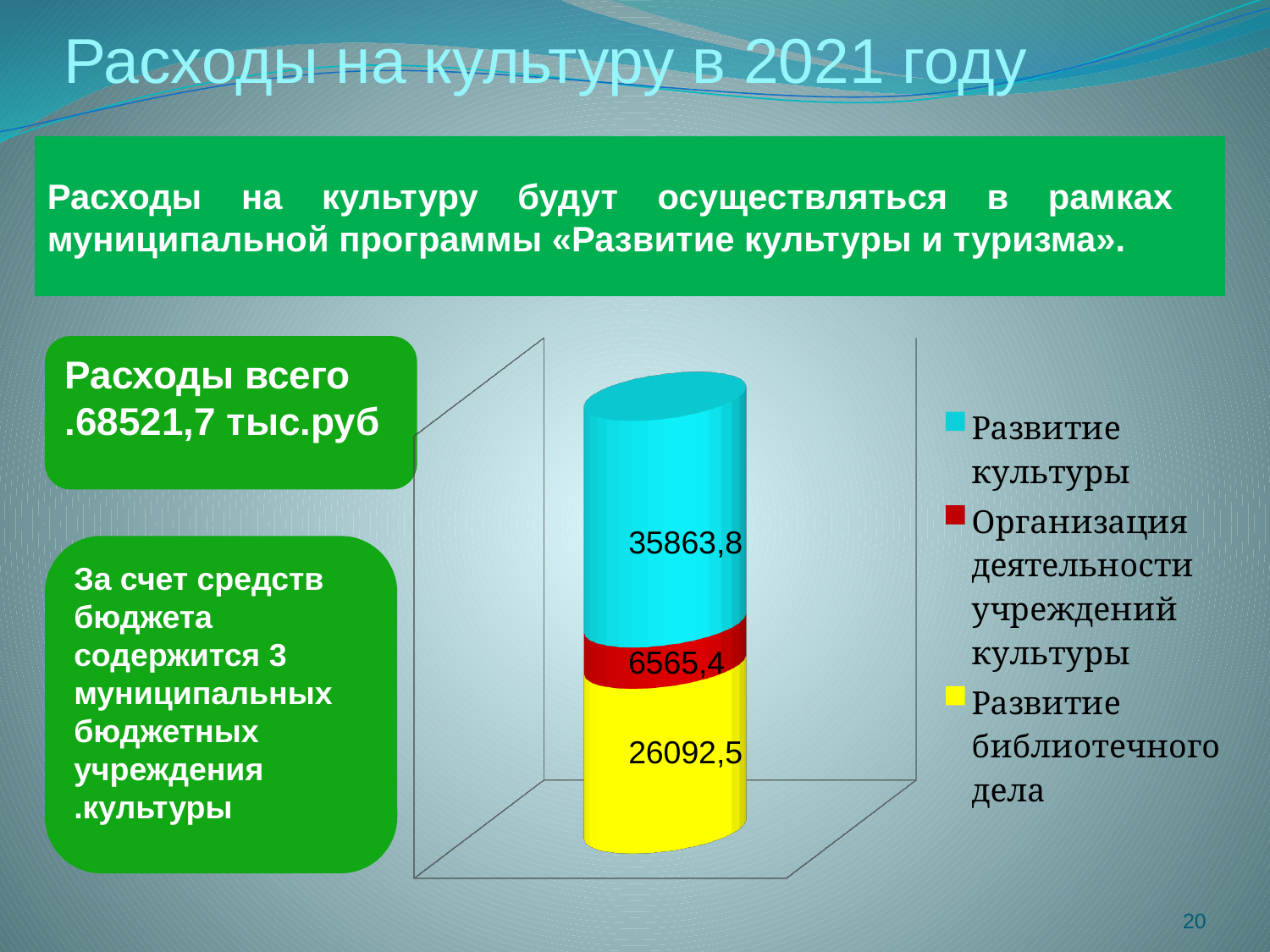
What is the difference between the values for Развитие культуры and Развитие библиотечного дела? 9771,3 Which series has the lowest value? Организация деятельности учреждений культуры Which series has the highest value? Развитие культуры How many series does the legend list? 3 What is the difference between the values for Развитие библиотечного дела and Организация деятельности учреждений культуры? 19527,1 What is the value for Организация деятельности учреждений культуры? 6565,4 What is the value for Развитие культуры? 35863,8 Which is larger: Развитие библиотечного дела or Организация деятельности учреждений культуры? Развитие библиотечного дела What colour represents Развитие библиотечного дела in the chart? Yellow What is the value for Развитие библиотечного дела? 26092,5 What is the total of the stacked bar? 68521,7 What kind of chart is shown? Stacked bar chart